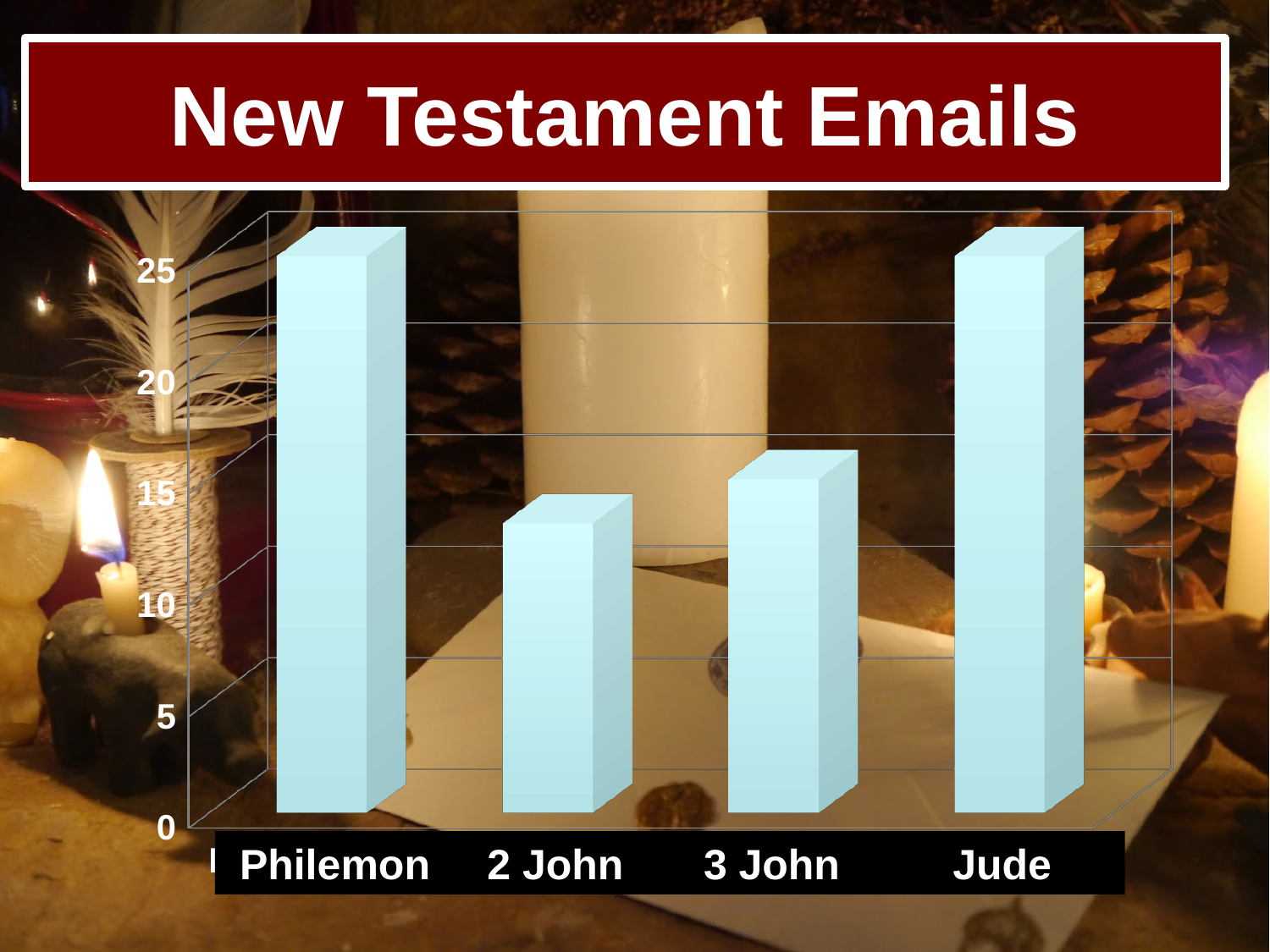
Is the value for 3 John greater or less than 10? greater Is the value for Jude greater or less than 20? greater Is the value for 2 John greater or less than 10? greater Which is larger, the value for 2 John or the value for 3 John? 3 John What is the title of the slide? New Testament Emails Which category has the lowest value? 2 John What is the highest value shown on the vertical axis? 25 How many categories are plotted on the chart? 4 What kind of chart is shown on the slide? bar chart